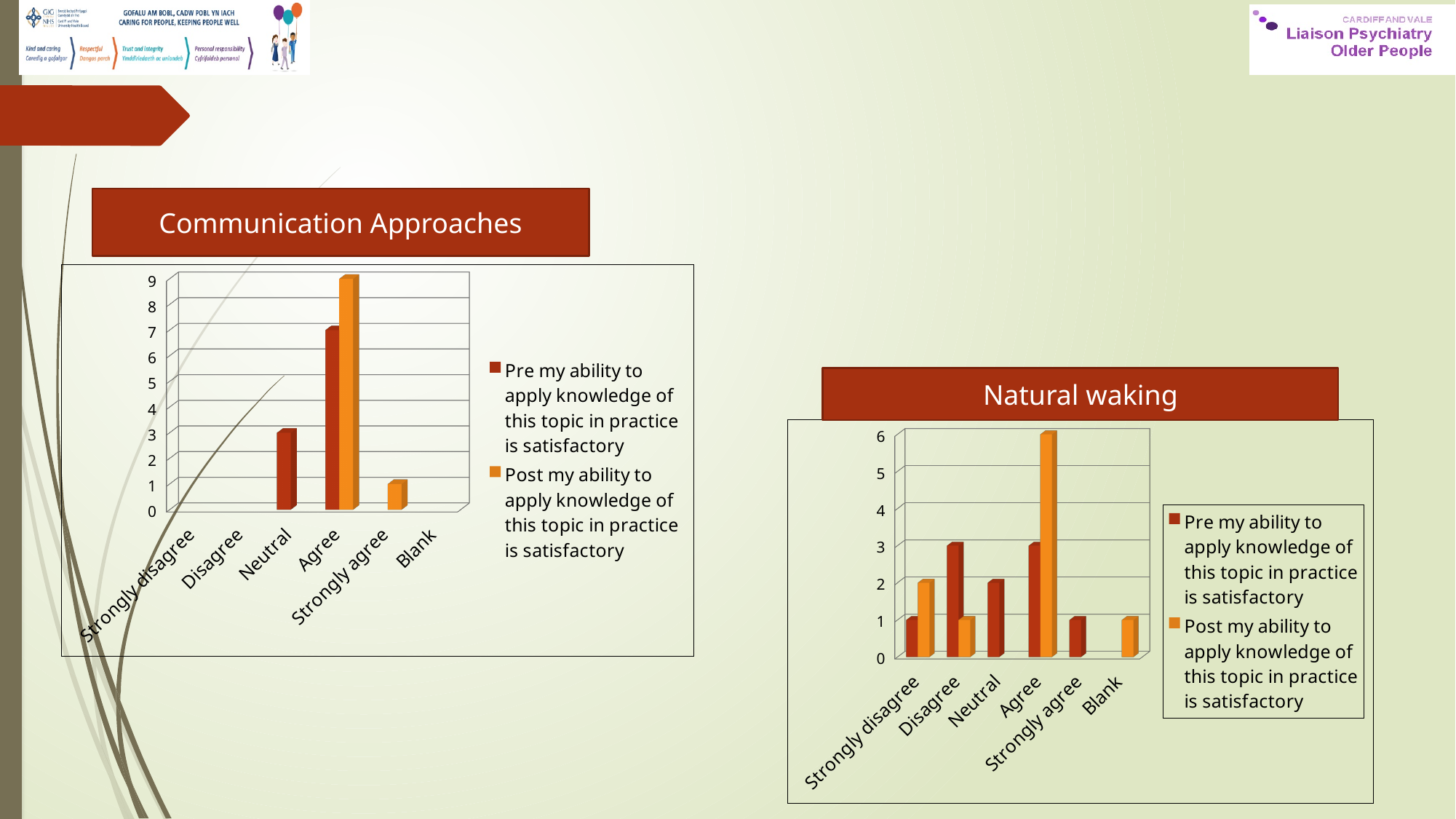
On the Communication Approaches chart, what type of chart is shown? bar chart On the Communication Approaches chart, is the Post value for Agree greater or less than 8? greater On the Communication Approaches chart, for the Agree category, is the Pre value or the Post value larger? Post On the Communication Approaches chart, is the Pre value for Neutral greater or less than 5? less On the Communication Approaches chart, how many series does the legend list? 2 On the Natural waking chart, which category has the highest value for the 'Post my ability to apply knowledge of this topic in practice is satisfactory' series? Agree On the Communication Approaches chart, which category has the highest value for the 'Post my ability to apply knowledge of this topic in practice is satisfactory' series? Agree On the Natural waking chart, what is the highest value shown on the vertical axis? 6 On the Natural waking chart, is the Post value for Agree greater or less than 5? greater On the Communication Approaches chart, how many categories are shown on the x axis? 6 On the Natural waking chart, for the Disagree category, is the Pre value or the Post value larger? Pre On the Communication Approaches chart, which category has the highest value for the 'Pre my ability to apply knowledge of this topic in practice is satisfactory' series? Agree